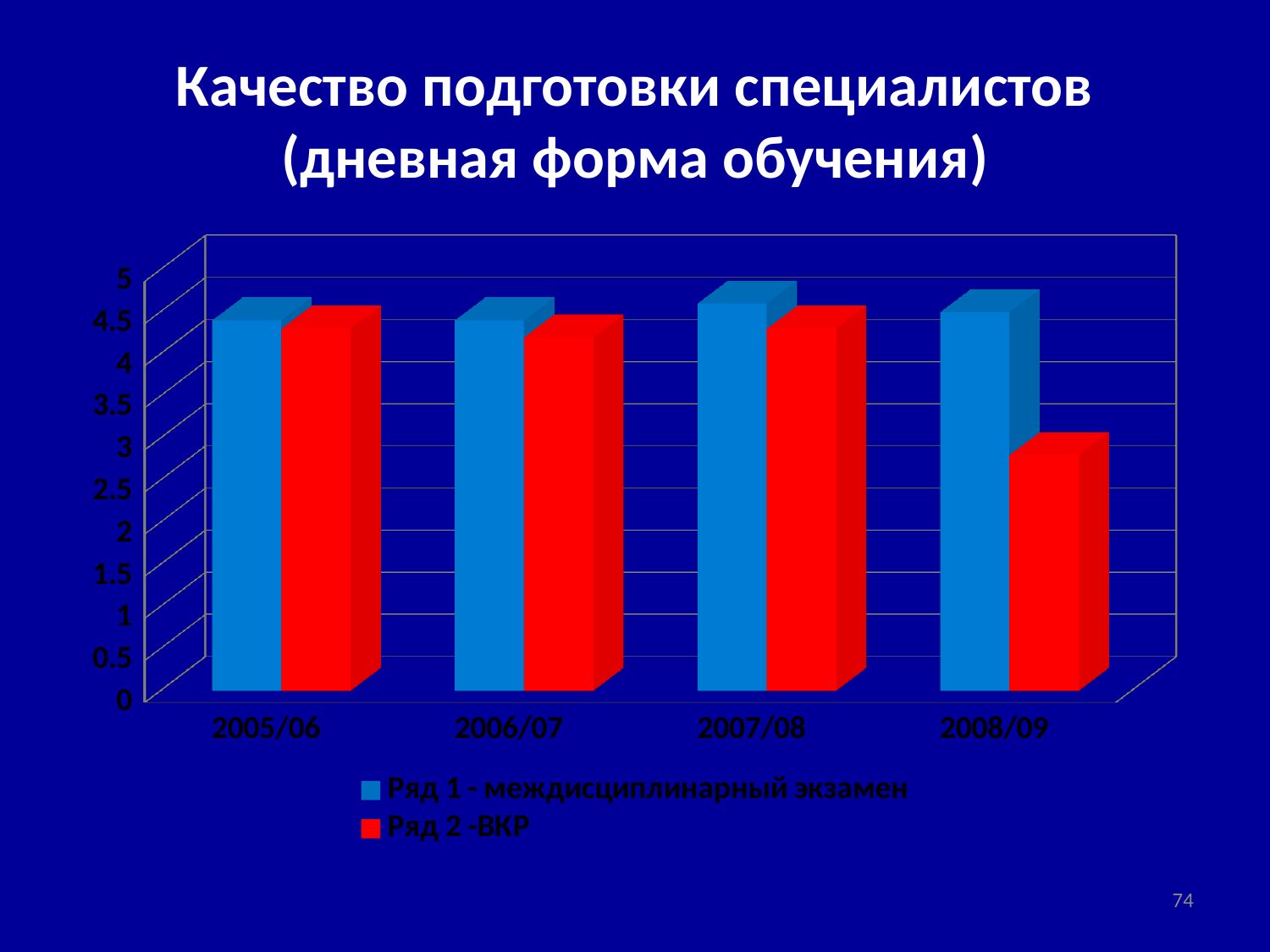
Which series has the lower value in 2008/09? Ряд 2 -ВКР Is the value for Ряд 2 -ВКР in 2006/07 greater or less than 3.5? greater In which academic year is the value for Ряд 2 -ВКР the lowest? 2008/09 What kind of chart is shown on the slide? bar chart How many academic years are shown on the x axis of the chart? 4 Does the value for Ряд 2 -ВКР rise or fall from 2007/08 to 2008/09? fall Which series is shown in red in the chart? Ряд 2 -ВКР What is the title of the slide containing the chart? Качество подготовки специалистов (дневная форма обучения) In 2008/09, which series has the larger value: Ряд 1 - междисциплинарный экзамен or Ряд 2 -ВКР? Ряд 1 - междисциплинарный экзамен Is the value for Ряд 2 -ВКР in 2008/09 greater or less than 3.5? less Is the value for Ряд 1 - междисциплинарный экзамен in 2005/06 greater or less than 4? greater How many series does the chart legend list? 2